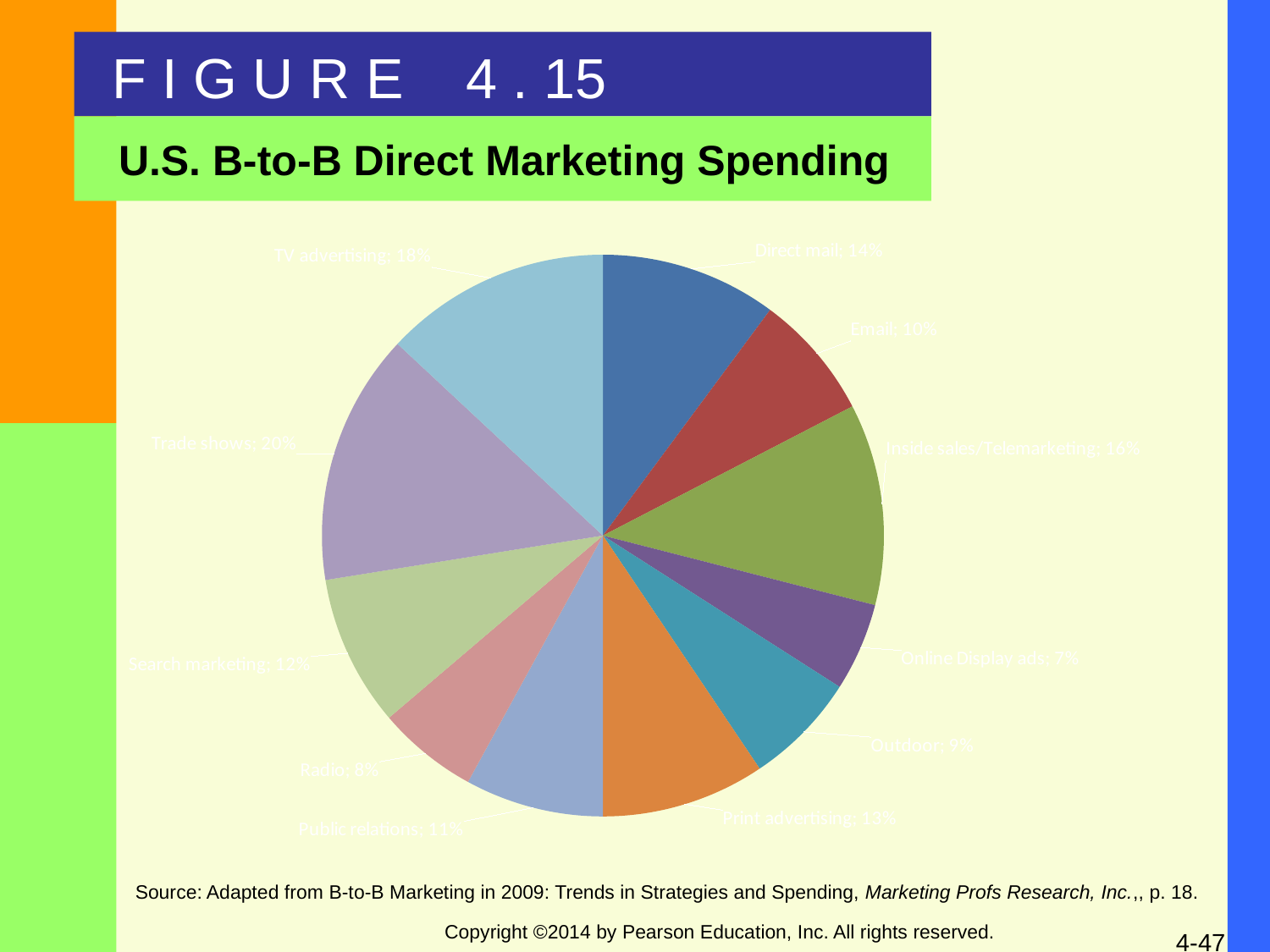
What is the title of the chart on the slide? U.S. B-to-B Direct Marketing Spending What percentage is shown for Inside sales/Telemarketing? 16% Which category has the smallest slice of the pie? Online Display ads How many categories are shown in the pie chart? 11 What percentage is shown for Online Display ads? 7% Which is larger, the value for Print advertising or the value for Public relations? Print advertising What percentage is shown for Direct mail? 14% What is the difference in percentage points between Trade shows and TV advertising? 2 percentage points What type of chart is shown on the slide? Pie chart What percentage is shown for Trade shows? 20% Which category has the largest slice of the pie? Trade shows What is the difference in percentage points between Search marketing and Radio? 4 percentage points